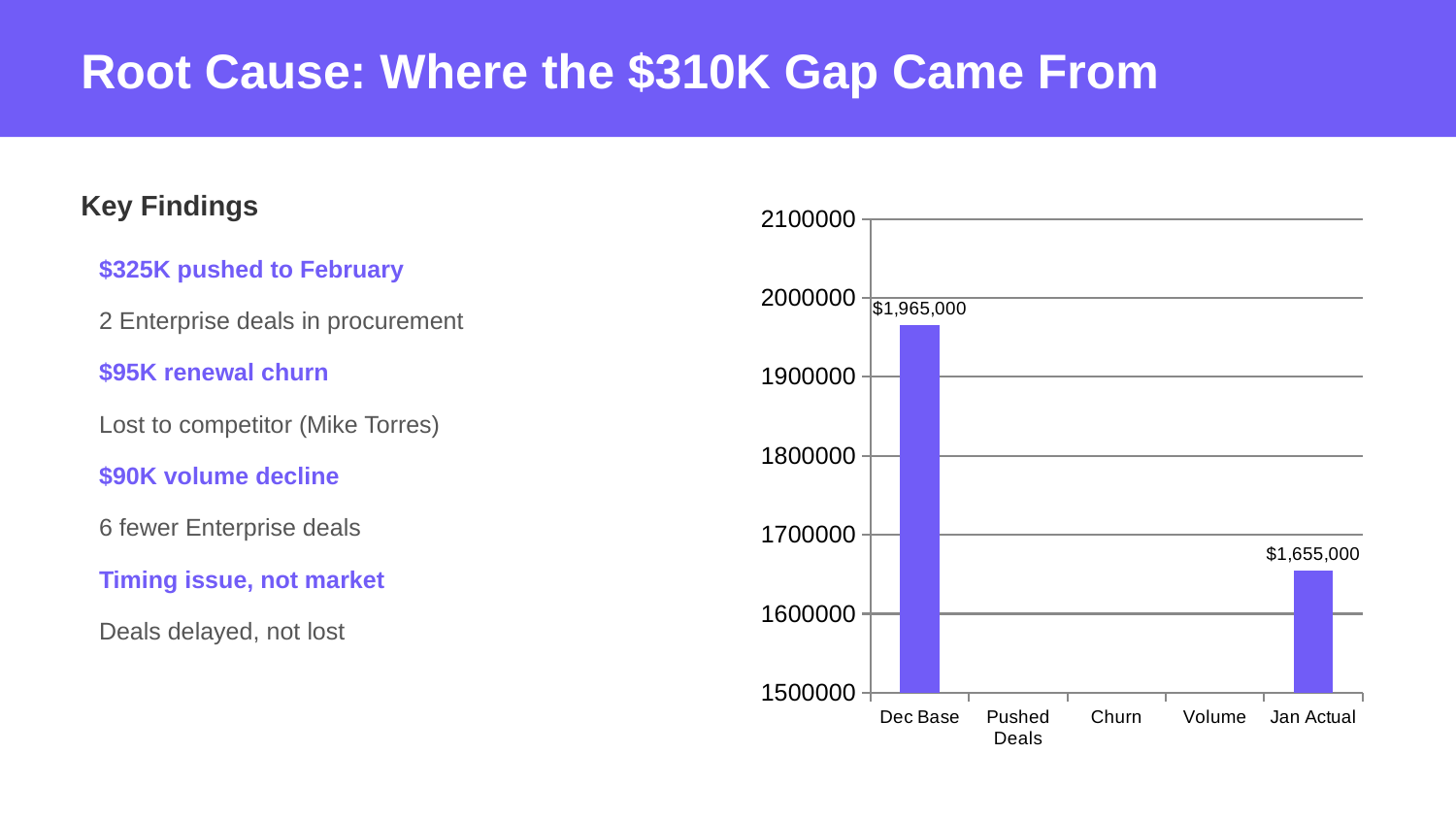
Which is larger, the Dec Base value or the Jan Actual value? Dec Base What is the value of the Jan Actual bar? $1,655,000 Which category has the tallest bar? Dec Base What is the lowest value shown on the y axis? 1500000 What is the value of the Dec Base bar? $1,965,000 Is the value for Jan Actual greater or less than 1700000? less How many categories are labelled on the x axis? 5 What colour are the bars in the chart? Purple What kind of chart is shown on the slide? Bar chart Is the value for Dec Base greater or less than 1900000? greater What is the difference between the Dec Base and Jan Actual values? $310,000 Does the value fall or rise from Dec Base to Jan Actual? Fall